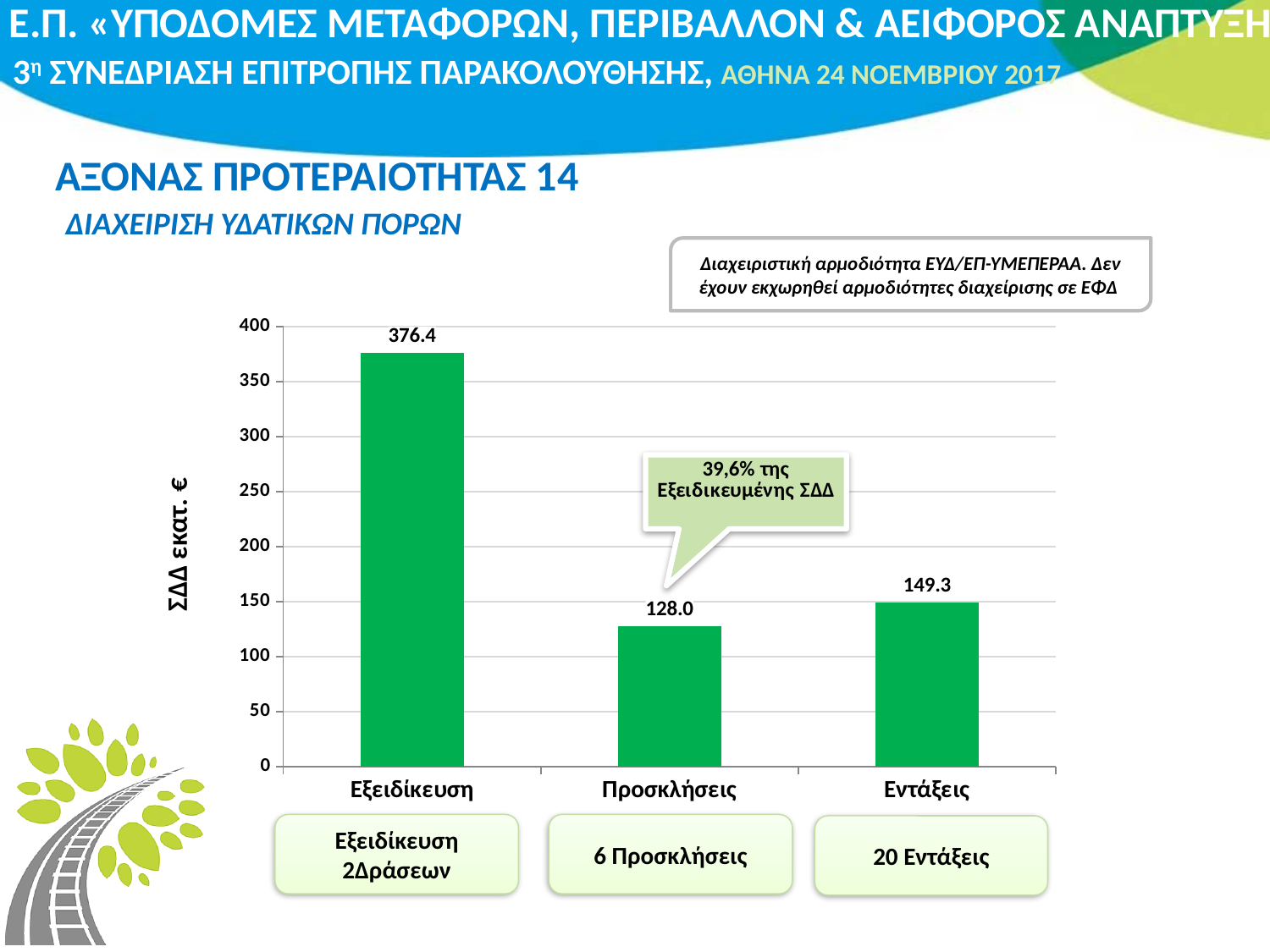
Is the value for Εξειδίκευση greater or less than 350? greater What is the difference between the values for Εξειδίκευση and Εντάξεις? 227.1 What is the difference between the values for Εντάξεις and Προσκλήσεις? 21.3 What is the value for Εντάξεις? 149.3 What is the label of the vertical axis? ΣΔΔ εκατ. € Which category has the highest value? Εξειδίκευση Which is larger, the value for Προσκλήσεις or the value for Εντάξεις? Εντάξεις What is the value for Εξειδίκευση? 376.4 Which category has the lowest value? Προσκλήσεις What is the value for Προσκλήσεις? 128.0 What kind of chart is shown on the slide? bar chart How many categories are shown on the x axis? 3